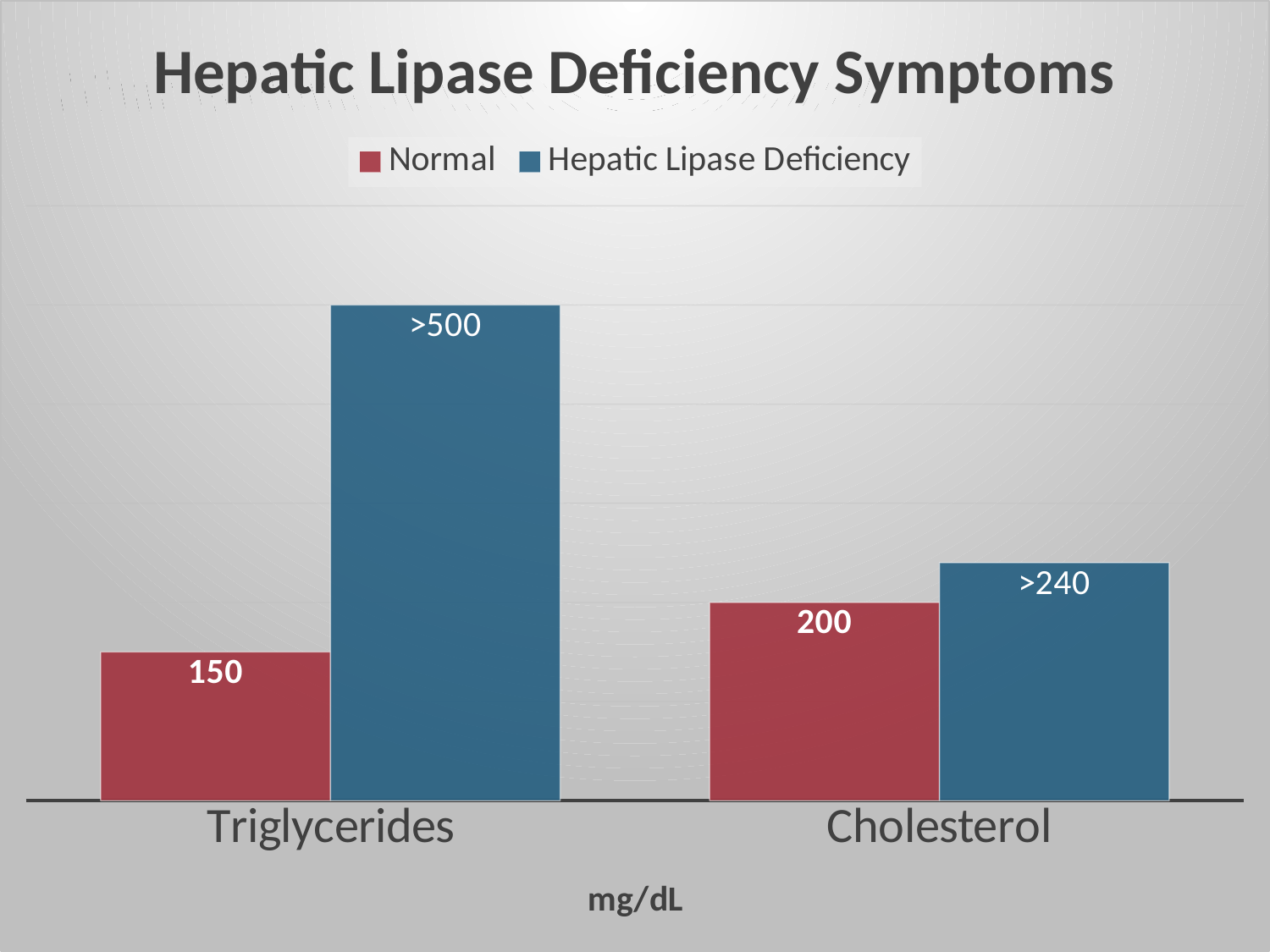
For Cholesterol, which is larger: the Normal value or the Hepatic Lipase Deficiency value? Hepatic Lipase Deficiency What is the Hepatic Lipase Deficiency value for Cholesterol? >240 Which bar is the tallest on the chart? Hepatic Lipase Deficiency for Triglycerides What is the Hepatic Lipase Deficiency value for Triglycerides? >500 What is the Normal value for Cholesterol? 200 What unit is shown below the x axis? mg/dL What is the Normal value for Triglycerides? 150 How many categories are shown on the x axis? 2 What is the difference between the Normal values for Cholesterol and Triglycerides? 50 What kind of chart is shown on the slide? Bar chart Which bar is the shortest on the chart? Normal for Triglycerides How many series does the legend list? 2